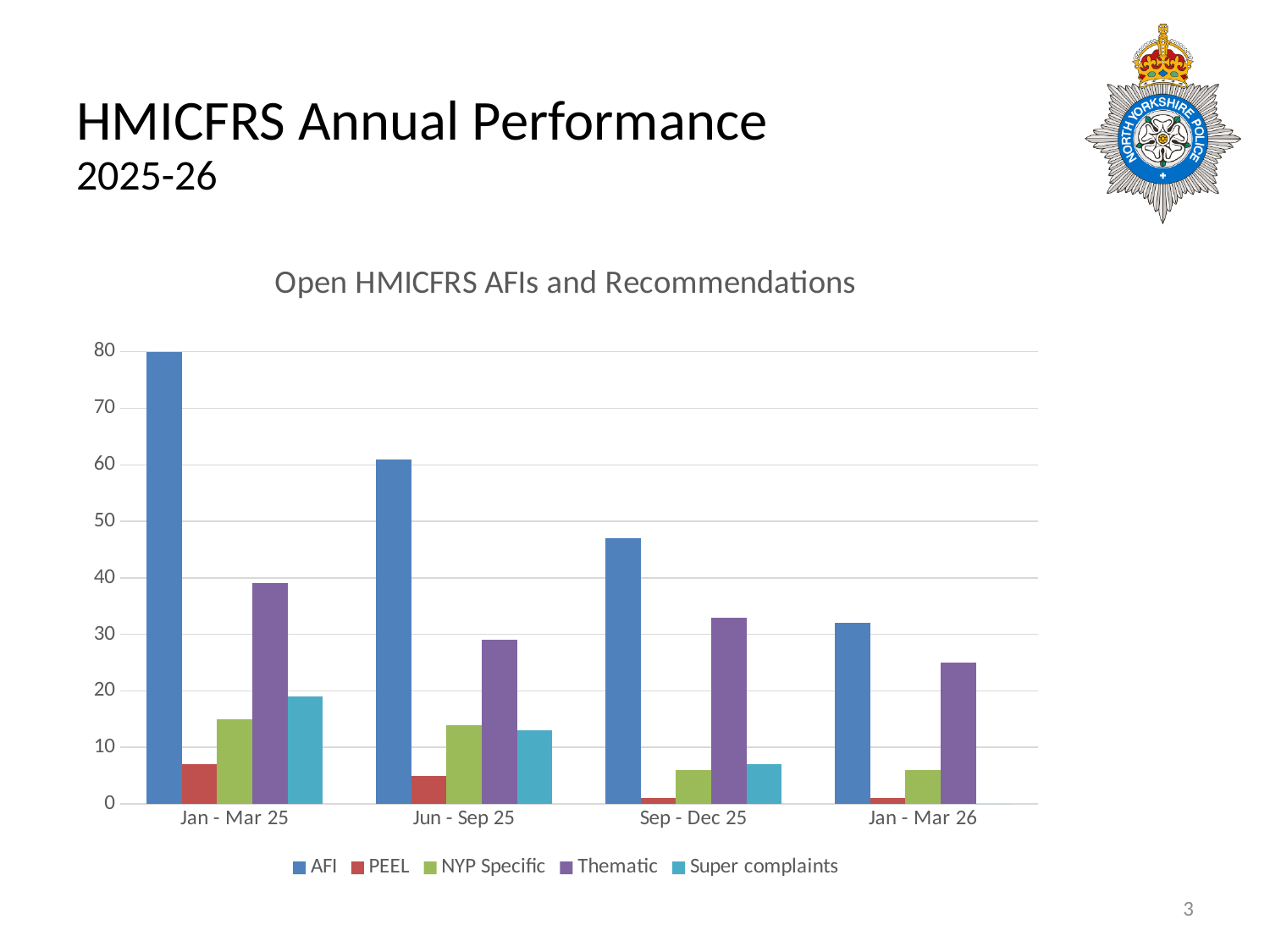
What is the AFI value for Jan - Mar 25? 80 In which period is the AFI value highest? Jan - Mar 25 What is the title of the chart? Open HMICFRS AFIs and Recommendations How many series does the legend list? 5 Which is larger for Jan - Mar 25: the Thematic value or the NYP Specific value? Thematic How many time periods are shown on the x axis? 4 Is the Thematic value for Sep - Dec 25 greater or less than 40? less In which period is the AFI value lowest? Jan - Mar 26 What type of chart is shown on the slide? bar chart Is the Super complaints value for Jan - Mar 25 greater or less than 10? greater Does the AFI value rise or fall across the periods from Jan - Mar 25 to Jan - Mar 26? fall